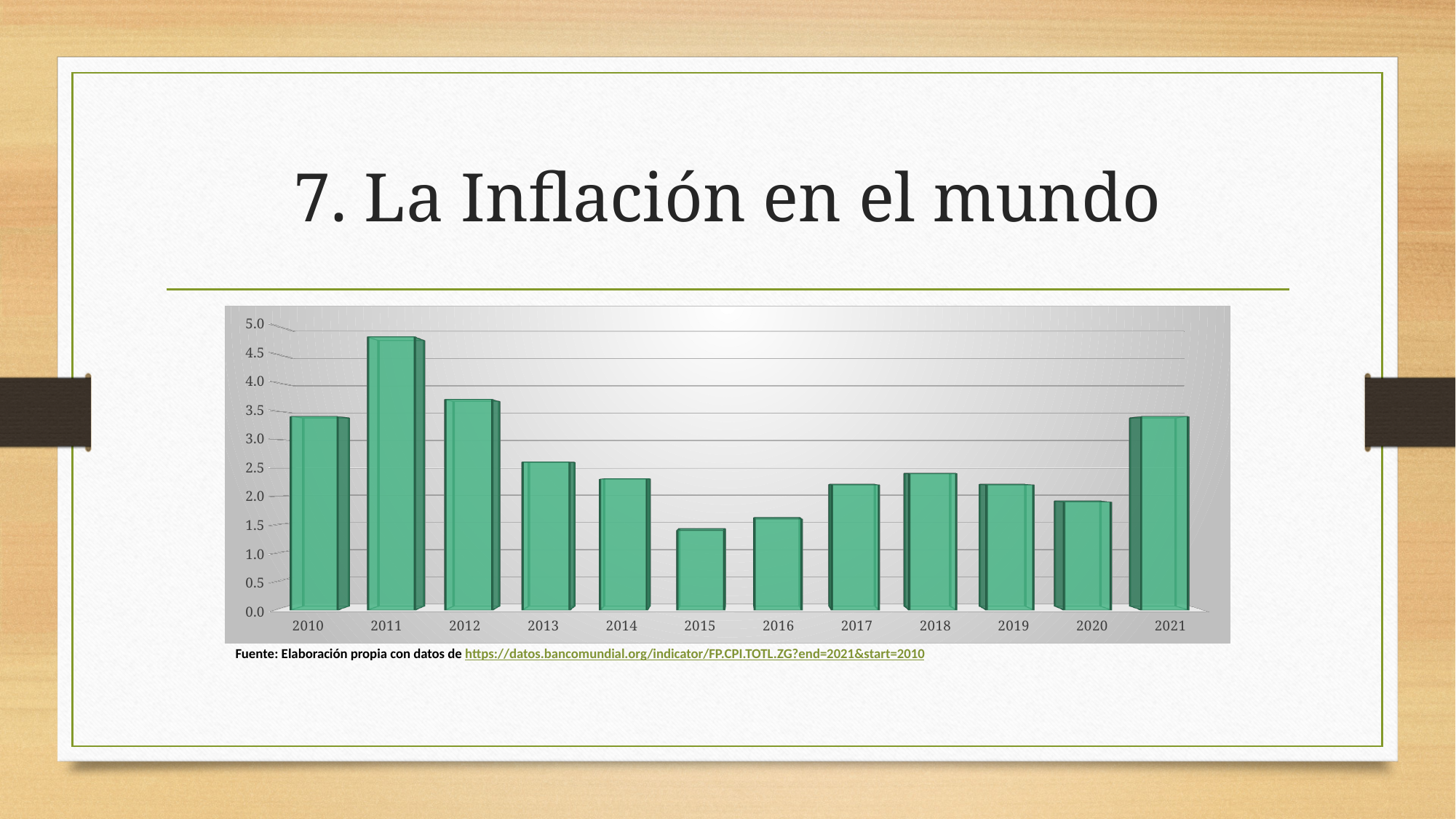
Which is larger, the value for 2020 or the value for 2021? 2021 How many years are shown on the x axis of the chart? 12 What kind of chart is shown on the slide? bar chart Which year has the lowest bar in the chart? 2015 Which year has the highest bar in the chart? 2011 Is the value for 2012 greater or less than 3.5? greater Which is larger, the value for 2011 or the value for 2012? 2011 Is the value for 2011 greater or less than 4.5? greater What is the first year shown on the x axis of the chart? 2010 Do the values rise or fall from 2011 to 2015? fall